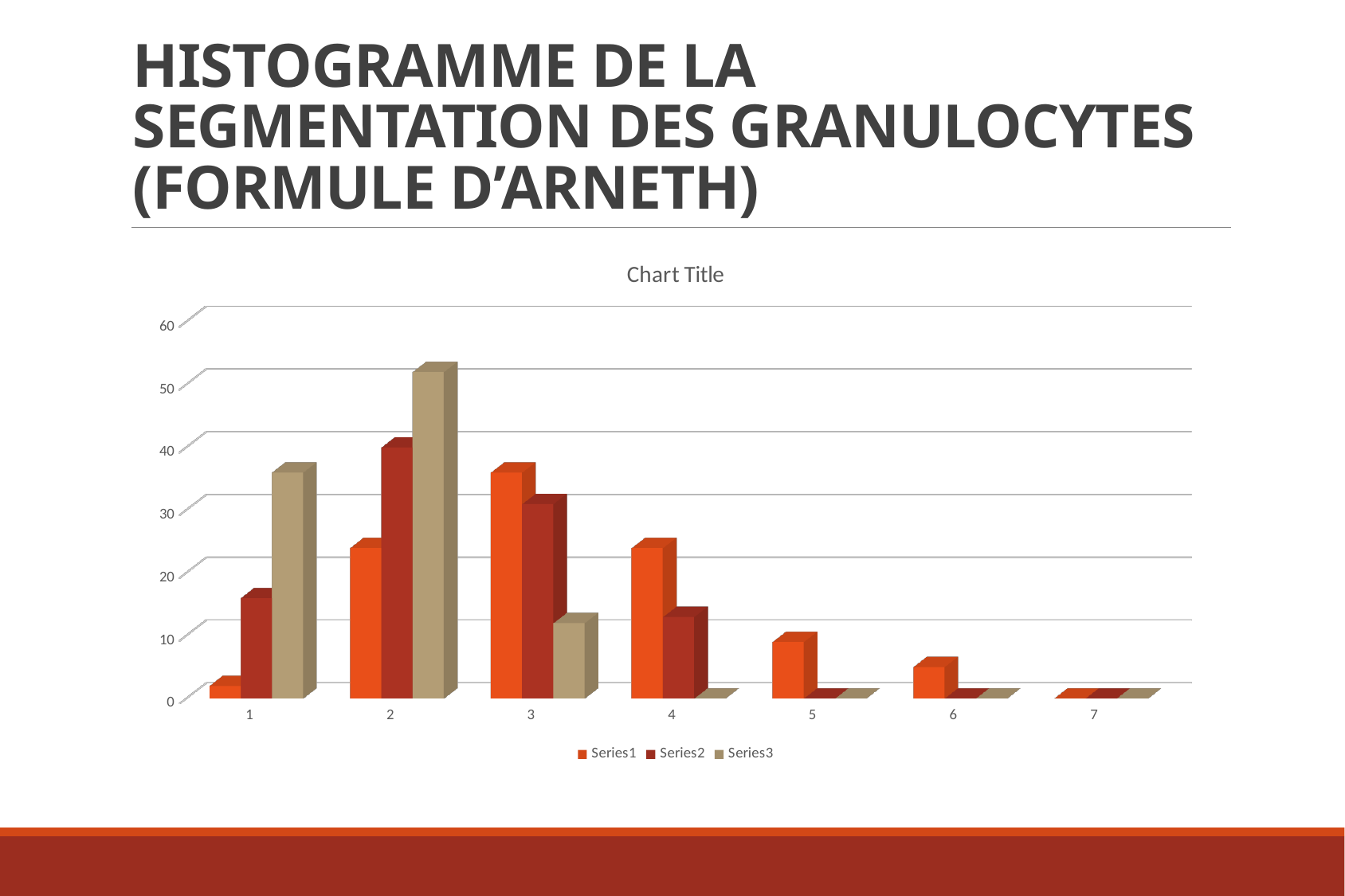
At category 1, which is larger: Series1 or Series3? Series3 What kind of chart is shown on the slide? bar chart Is the value for Series3 at category 2 greater or less than 40? greater Is the value for Series1 at category 1 greater or less than 10? less For Series3, which category has the highest value? 2 For Series1, which category has the highest value? 3 How many series does the legend list? 3 What is the title shown above the chart? Chart Title Do the values for Series3 rise or fall from category 2 to category 7? fall At category 3, which is larger: Series1 or Series2? Series1 For Series2, which category has the highest value? 2 How many categories are shown on the x axis? 7